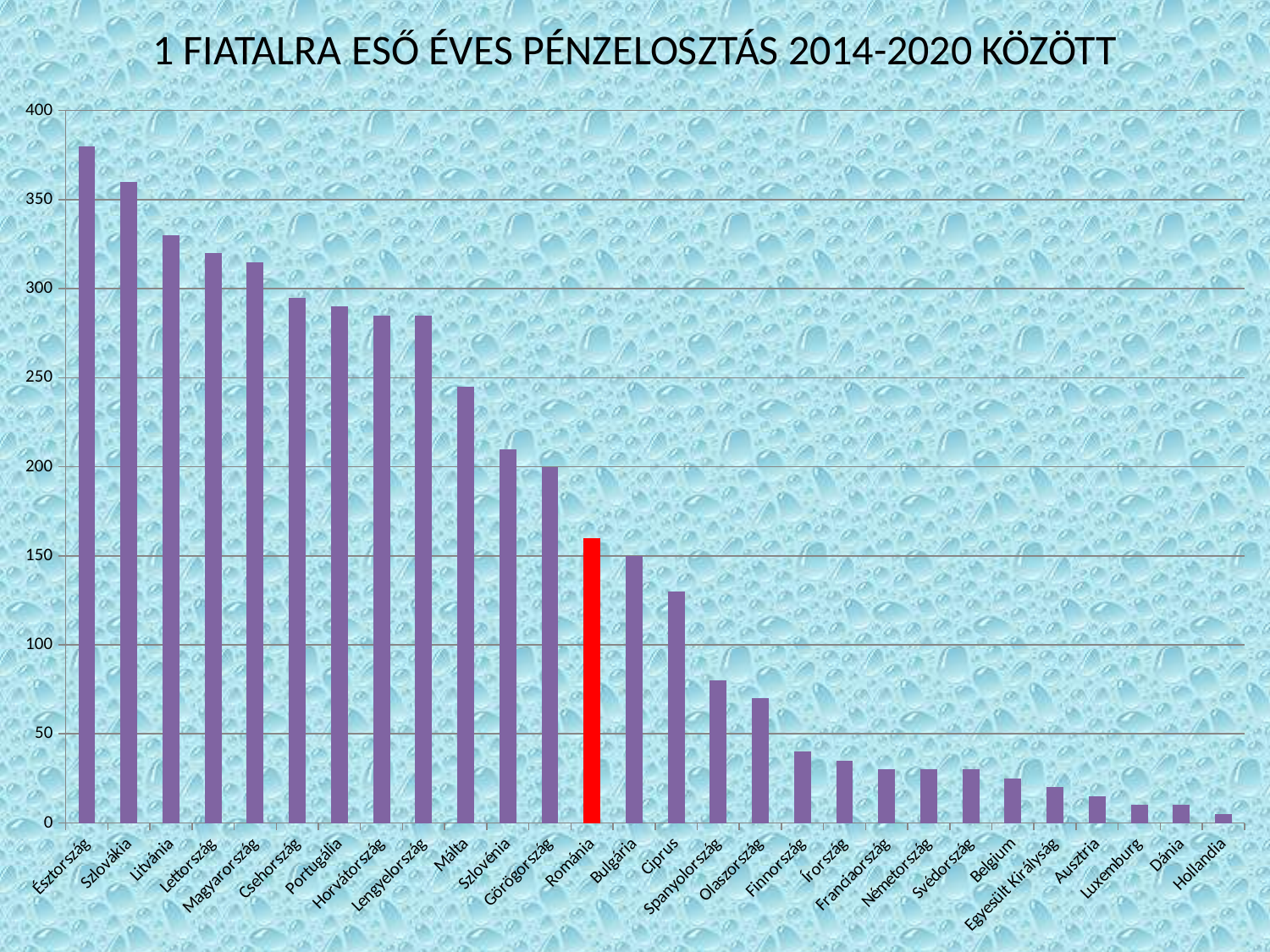
Which country has the lowest value in the chart? Hollandia What kind of chart is shown on the slide? bar chart Which country's bar is coloured red instead of purple? Románia Do the values rise or fall moving from left to right along the x axis? fall How many countries are shown on the x axis of the chart? 28 Which has the larger value, Litvánia or Málta? Litvánia Is the value for Ciprus greater or less than 150? less Which country has the highest value in the chart? Észtország Is the value for Észtország greater or less than 350? greater Is the value for Románia greater or less than 150? greater What is the title of the chart? 1 FIATALRA ESŐ ÉVES PÉNZELOSZTÁS 2014-2020 KÖZÖTT